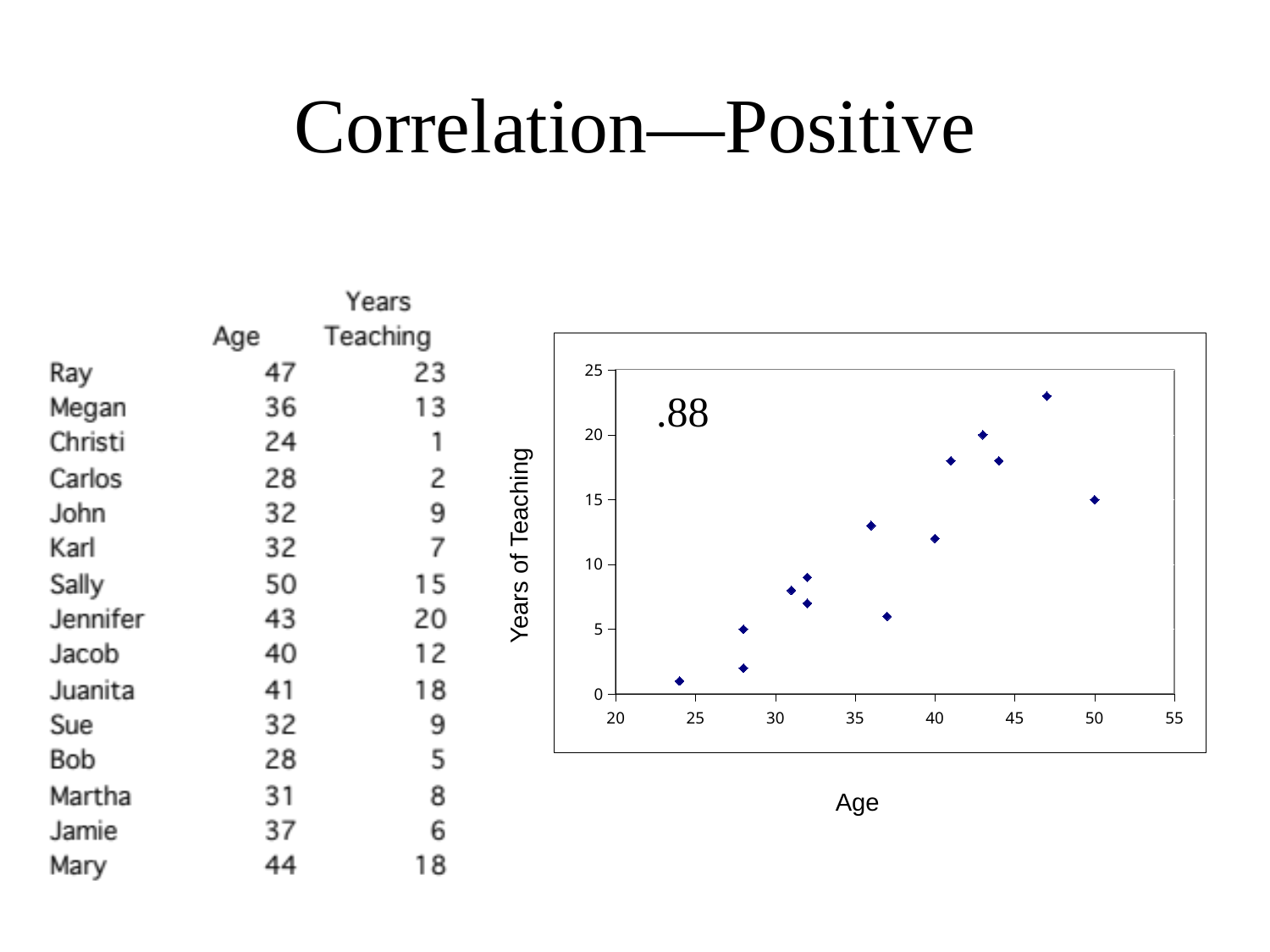
As age increases along the x axis, do the years of teaching values generally rise or fall? rise At which age does the point with the lowest years of teaching appear? 24 Is the years of teaching value for the point at age 24 greater or less than 5? less According to the data table, how many years of teaching does Ray have? 23 At which age does the point with the highest years of teaching appear? 47 What is the label of the x axis of the chart? Age According to the data table, what is Jennifer's age? 43 Is the years of teaching value for the point at age 41 greater or less than 15? greater What kind of chart is shown on the slide? scatter plot What is the label of the y axis of the chart? Years of Teaching Which has more years of teaching, the point at age 36 or the point at age 37? age 36 Is the years of teaching value for the point at age 47 greater or less than 20? greater